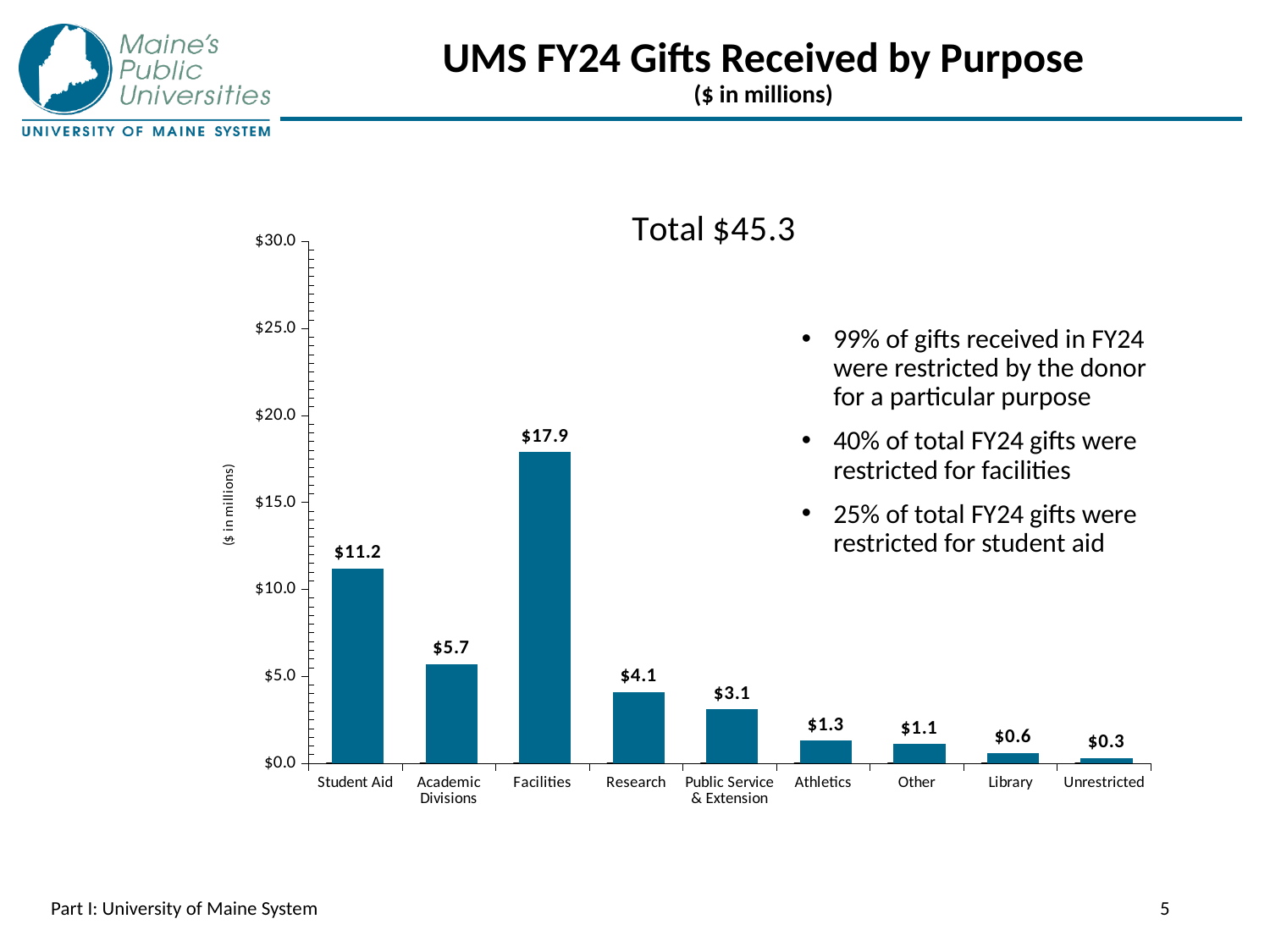
Which category has the lowest value? Unrestricted What kind of chart is shown on the slide? bar chart What total is stated above the chart? Total $45.3 How many categories are shown on the x axis? 9 What is the difference between the values for Facilities and Student Aid? $6.7 Is the value for Student Aid greater or less than $10.0? greater What is the value for Facilities? $17.9 What is the difference between the values for Athletics and Library? $0.7 Which category has the highest value? Facilities Which is larger, the value for Research or the value for Academic Divisions? Academic Divisions What is the value for Student Aid? $11.2 What is the value for Public Service & Extension? $3.1